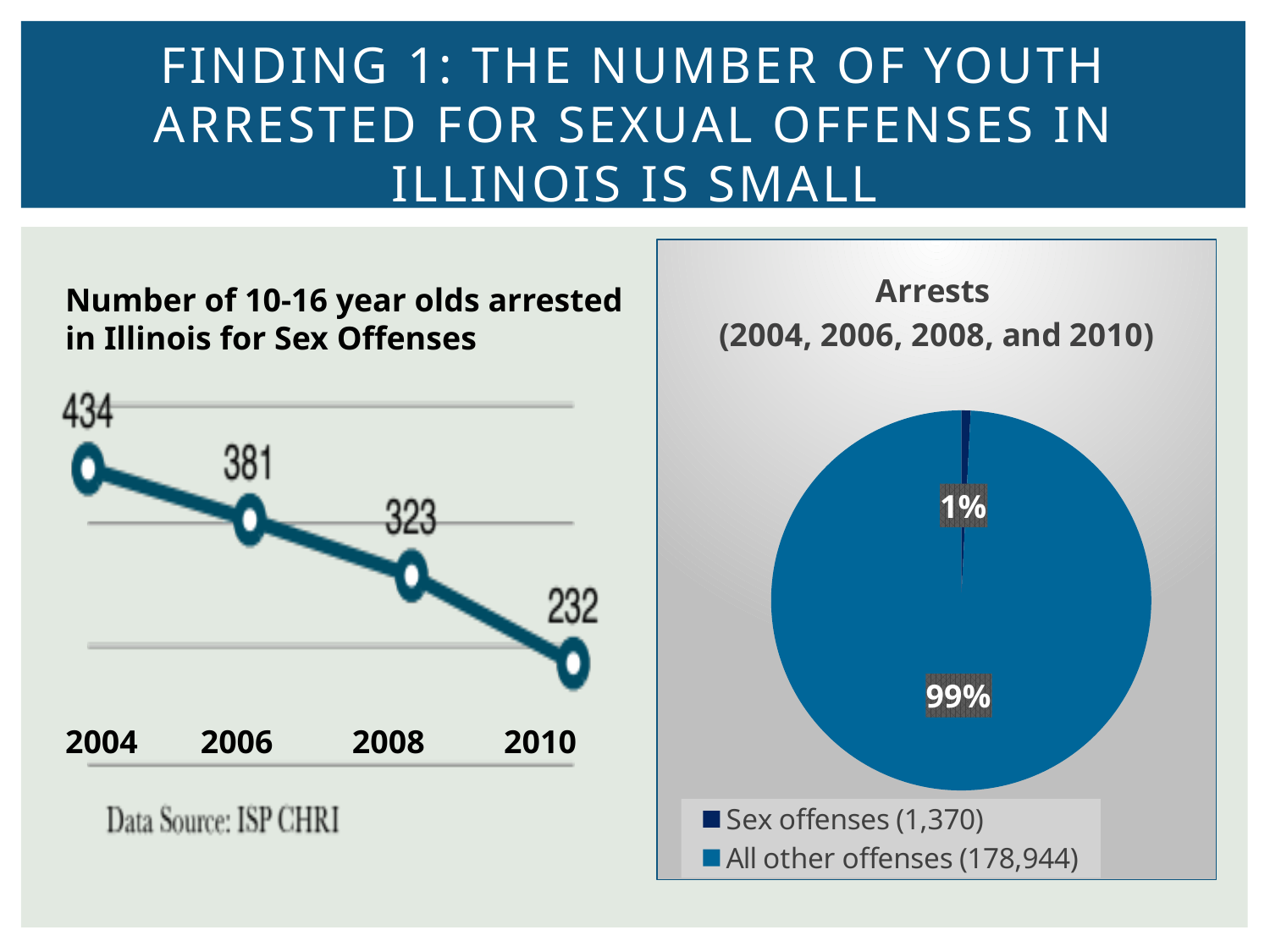
In the line chart on the left, what is the difference between the 2006 and 2008 values? 58 In the line chart 'Number of 10-16 year olds arrested in Illinois for Sex Offenses', what is the value for 2008? 323 In the pie chart 'Arrests (2004, 2006, 2008, and 2010)', what share of arrests is for sex offenses? 1% In the line chart 'Number of 10-16 year olds arrested in Illinois for Sex Offenses', what is the value for 2004? 434 In the line chart on the left, do the values rise or fall from 2004 to 2010? fall What kind of chart is the 'Arrests (2004, 2006, 2008, and 2010)' chart on the right? pie chart How many data points are plotted in the line chart on the left? 4 In the line chart on the left, what is the difference between the 2004 and 2010 values? 202 In the pie chart on the right, what number of arrests does the legend give for 'All other offenses'? 178,944 In the line chart on the left, which year has the highest number of arrests? 2004 In the line chart 'Number of 10-16 year olds arrested in Illinois for Sex Offenses', what is the value for 2010? 232 In the line chart on the left, which year has the lowest number of arrests? 2010